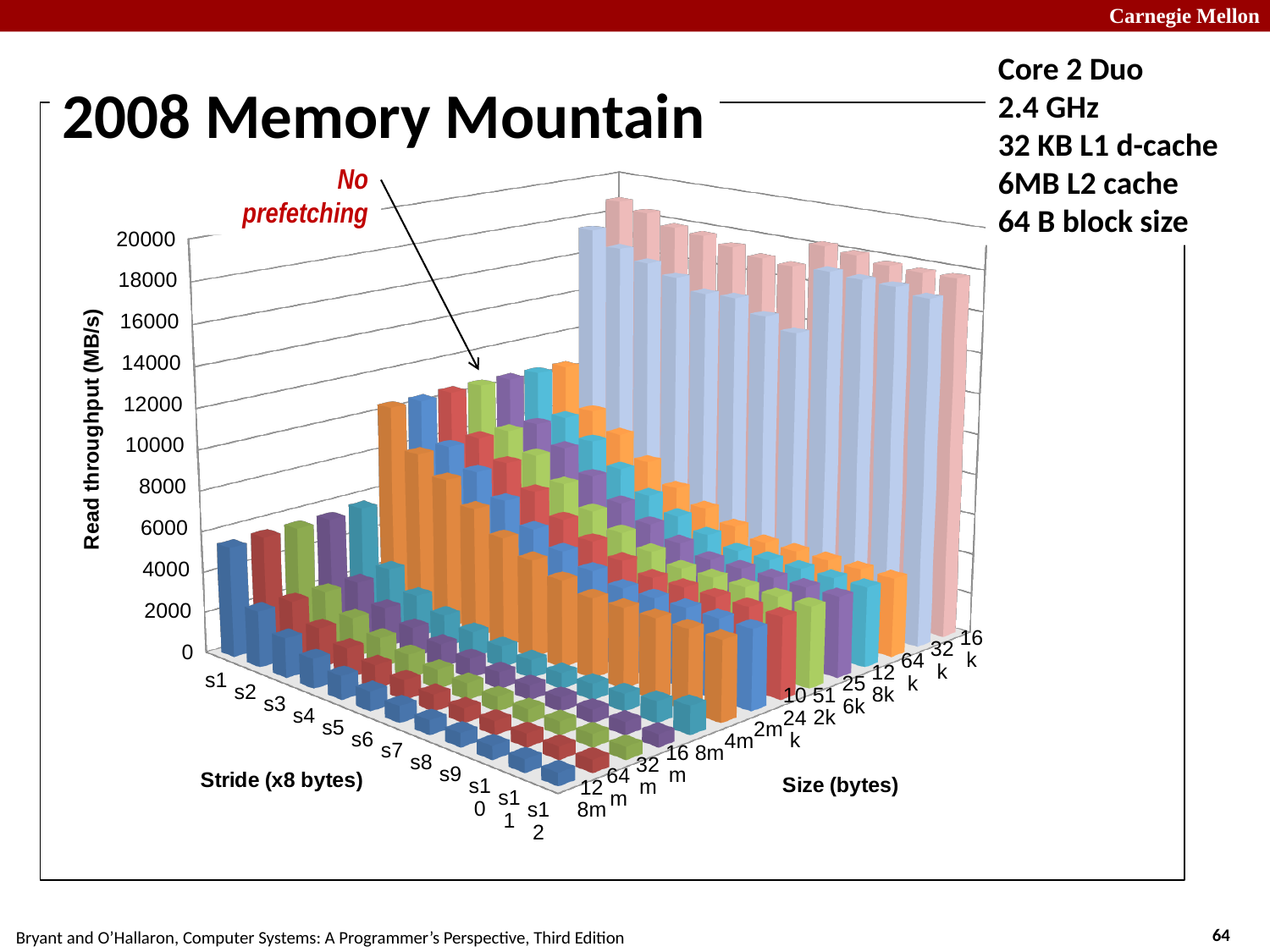
Is the read throughput for stride s1 at size 16k greater or less than 16000 MB/s? greater What is the title of the chart? 2008 Memory Mountain What annotation with an arrow is placed on the chart? No prefetching How many stride categories are shown along the stride axis? 12 What kind of chart is shown on the slide? 3D bar chart Is the read throughput for stride s1 at size 128m greater or less than 10000 MB/s? less Which size has higher read throughput at stride s1: 16k or 128m? 16k Is the read throughput for stride s12 at size 16k greater or less than 14000 MB/s? greater